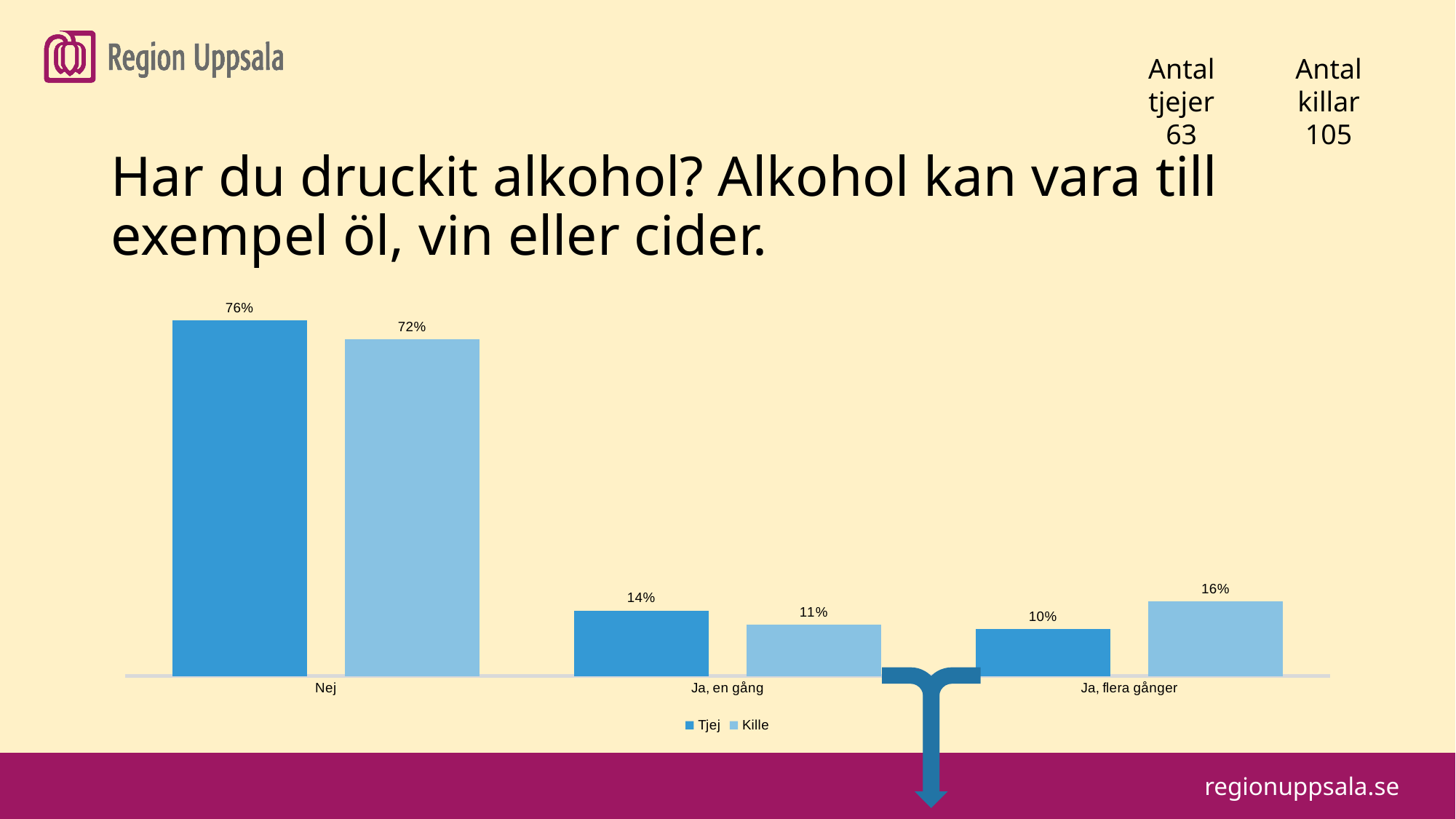
Which category has the lowest value for Kille? Ja, en gång Which category has the highest value for Tjej? Nej What kind of chart is shown on the slide? Bar chart What is the value for Tjej in the Nej category? 76% How many series does the legend list? 2 What is the value for Kille in the Nej category? 72% How many categories are shown on the x axis? 3 What is the value for Kille in the Ja, flera gånger category? 16% In the Ja, flera gånger category, which series has the larger value, Tjej or Kille? Kille What is the difference between the Tjej and Kille values in the Nej category? 4% What are the two series named in the legend? Tjej and Kille What is the value for Tjej in the Ja, en gång category? 14%